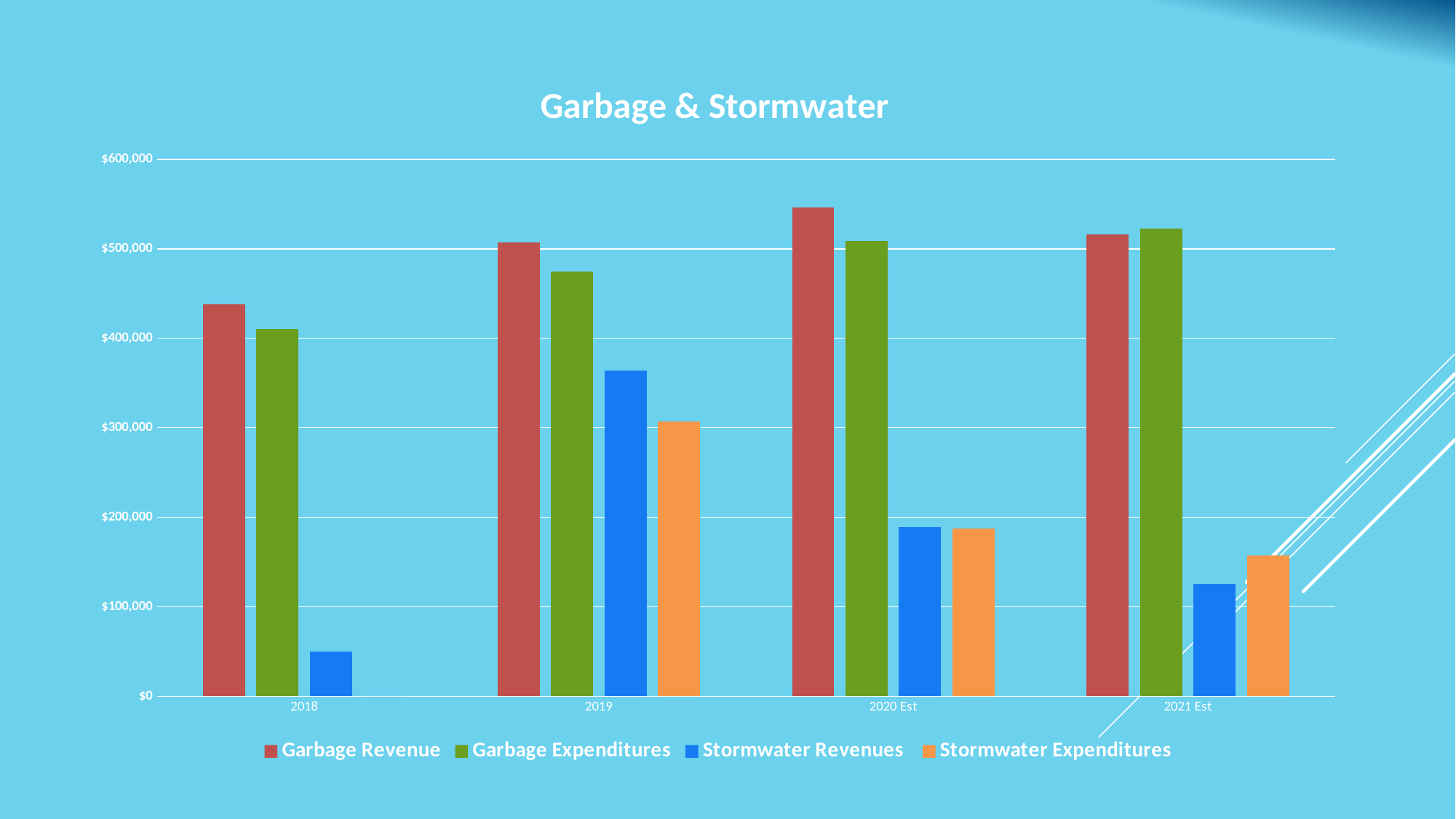
How many year categories are shown on the x axis? 4 In which year is Stormwater Revenues lowest? 2018 In 2019, which is larger: Garbage Revenue or Garbage Expenditures? Garbage Revenue Do Stormwater Revenues rise or fall from 2019 to 2021 Est? fall Is the value for Garbage Revenue in 2018 greater or less than $400,000? greater In which year is Stormwater Revenues highest? 2019 Is the value for Stormwater Revenues in 2018 greater or less than $100,000? less Is the value for Garbage Revenue in 2020 Est greater or less than $500,000? greater How many series does the legend list? 4 What is the title of the chart? Garbage & Stormwater In which year is Garbage Revenue highest? 2020 Est What kind of chart is shown on the slide? bar chart